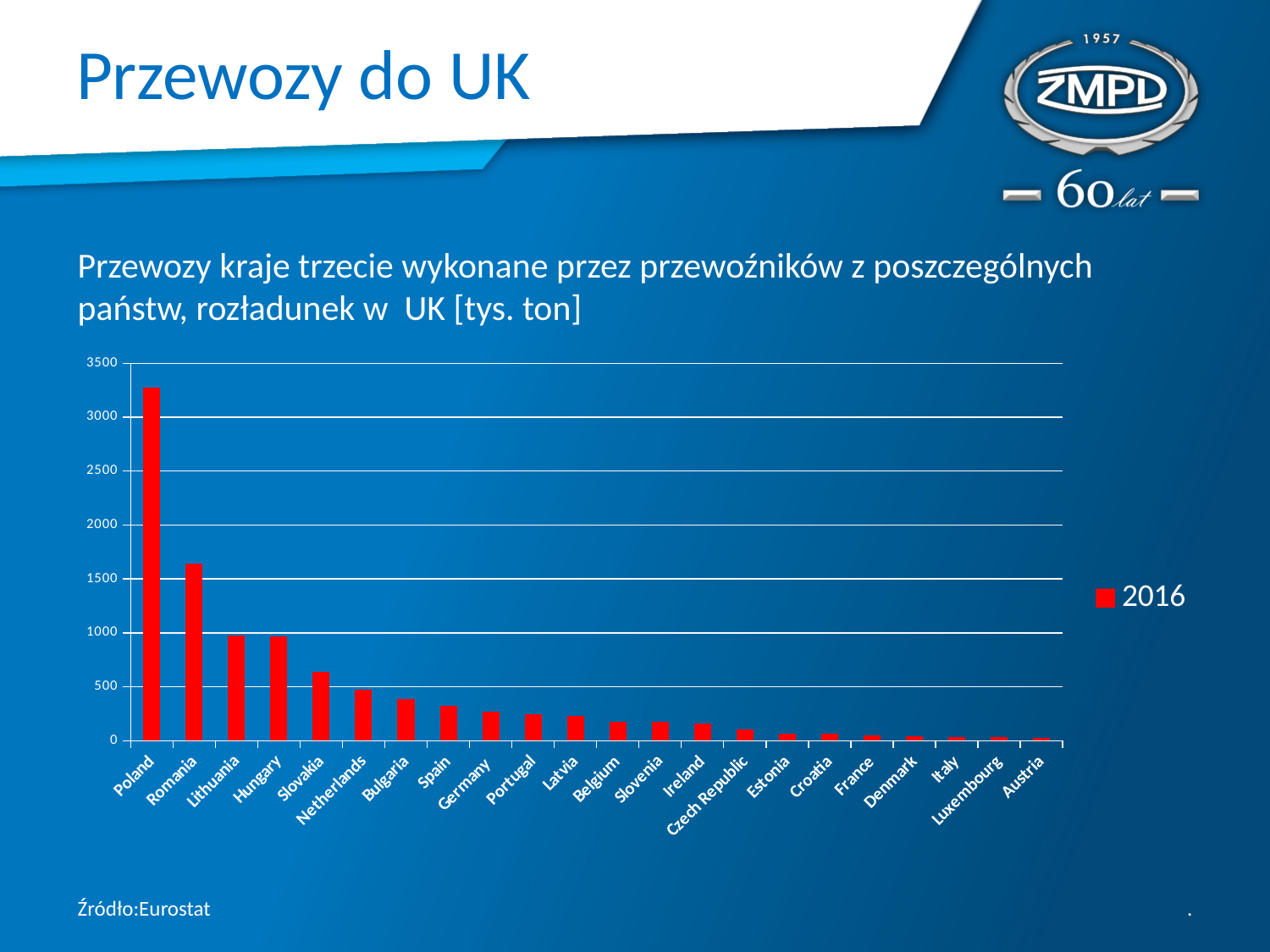
Do the values rise or fall moving from left to right along the x axis? fall Is the value for Romania greater or less than 1500? greater How many countries are shown on the x axis? 22 Is the value for Poland greater or less than 3000? greater Which has a larger value, Slovakia or Bulgaria? Slovakia What kind of chart is shown on the slide? bar chart Which country has the highest value? Poland What is the legend entry for the series shown? 2016 How many series does the legend list? 1 Which has a larger value, Romania or Lithuania? Romania Is the value for Slovakia greater or less than 500? greater